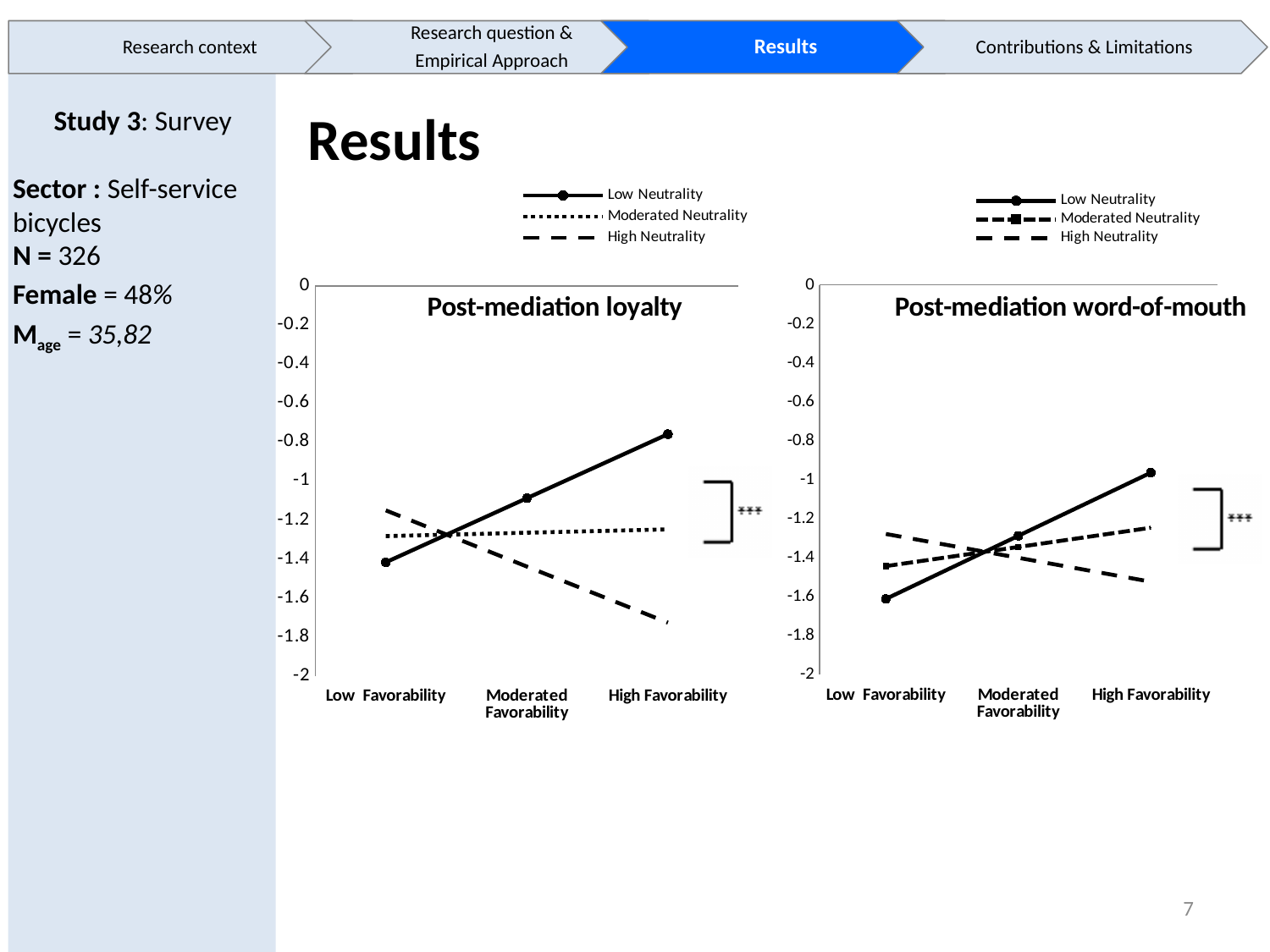
In the Post-mediation loyalty chart, is the Low Neutrality value at High Favorability greater or less than -1? greater In the Post-mediation word-of-mouth chart, is the Low Neutrality value at Low Favorability greater or less than -1.4? less In the Post-mediation loyalty chart, does the Low Neutrality line rise or fall from Low Favorability to High Favorability? rise How many series does the legend of the Post-mediation word-of-mouth chart list? 3 In the Post-mediation word-of-mouth chart, does the Low Neutrality line rise or fall along the x axis? rise What kind of chart is the Post-mediation loyalty chart? line chart In the Post-mediation loyalty chart, at High Favorability, which series has the higher value: Low Neutrality or High Neutrality? Low Neutrality In the Post-mediation word-of-mouth chart, is the Low Neutrality value at High Favorability greater or less than -1.2? greater What is the title of the chart on the right side of the slide? Post-mediation word-of-mouth In the Post-mediation loyalty chart, does the High Neutrality line rise or fall from Low Favorability to High Favorability? fall How many categories are on the x axis of the Post-mediation loyalty chart? 3